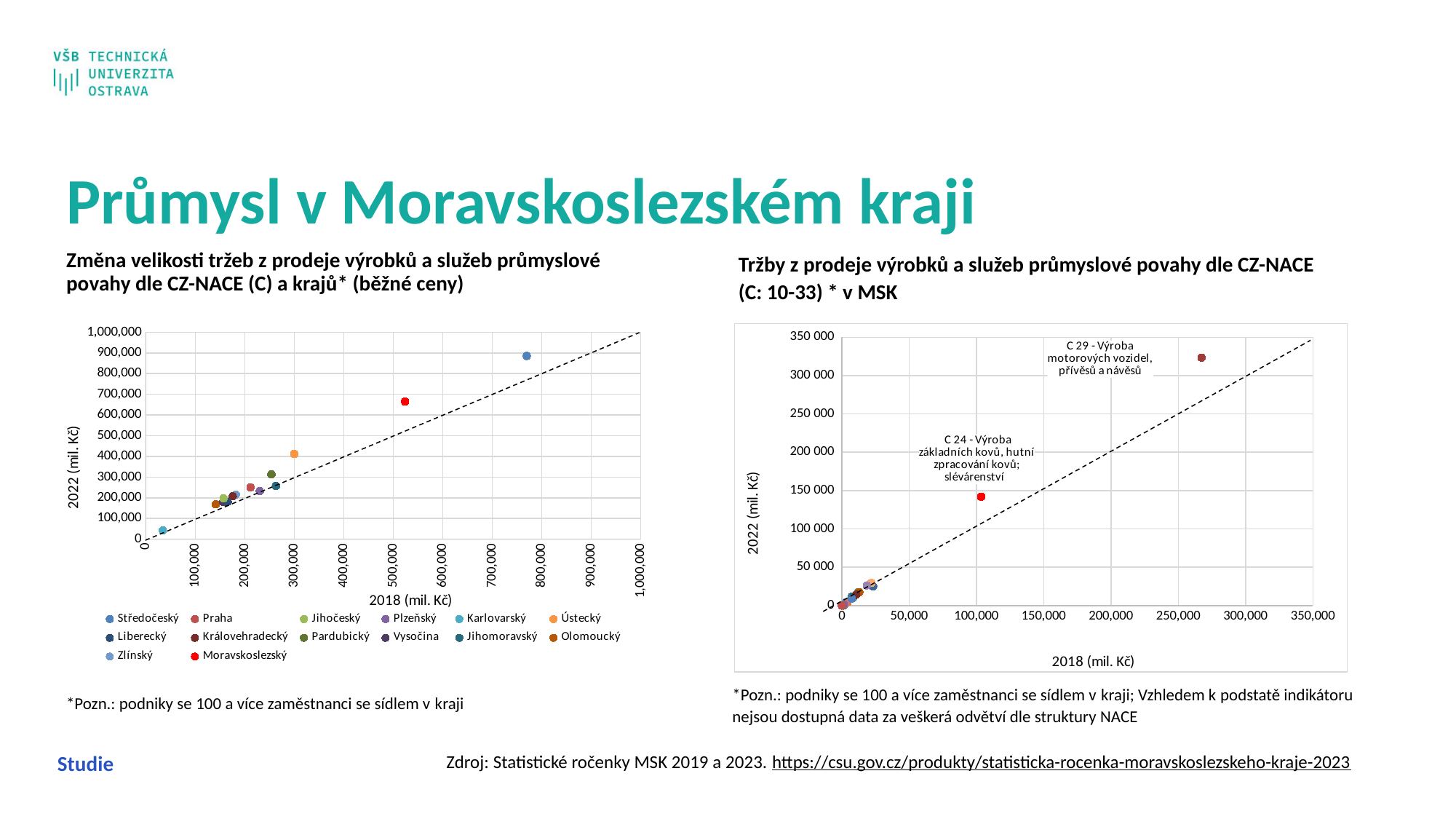
In the left chart (regions), is the 2018 value for Ústecký greater or less than 400,000? less In the left chart (regions), is the 2022 value for Středočeský greater or less than 800,000? greater In the left chart (regions), is the 2022 value for Moravskoslezský greater or less than 600,000? greater What kind of chart is the left chart, 'Změna velikosti tržeb z prodeje výrobků a služeb průmyslové povahy dle CZ-NACE (C) a krajů'? Scatter chart In the right chart (MSK by CZ-NACE), what is the title of the horizontal axis? 2018 (mil. Kč) In the left chart (regions), how many regions does the legend list? 14 In the left chart (regions), which region has the highest 2022 value? Středočeský In the left chart (regions), which has the larger 2022 value, Moravskoslezský or Ústecký? Moravskoslezský In the left chart (regions), which region has the lowest 2022 value? Karlovarský